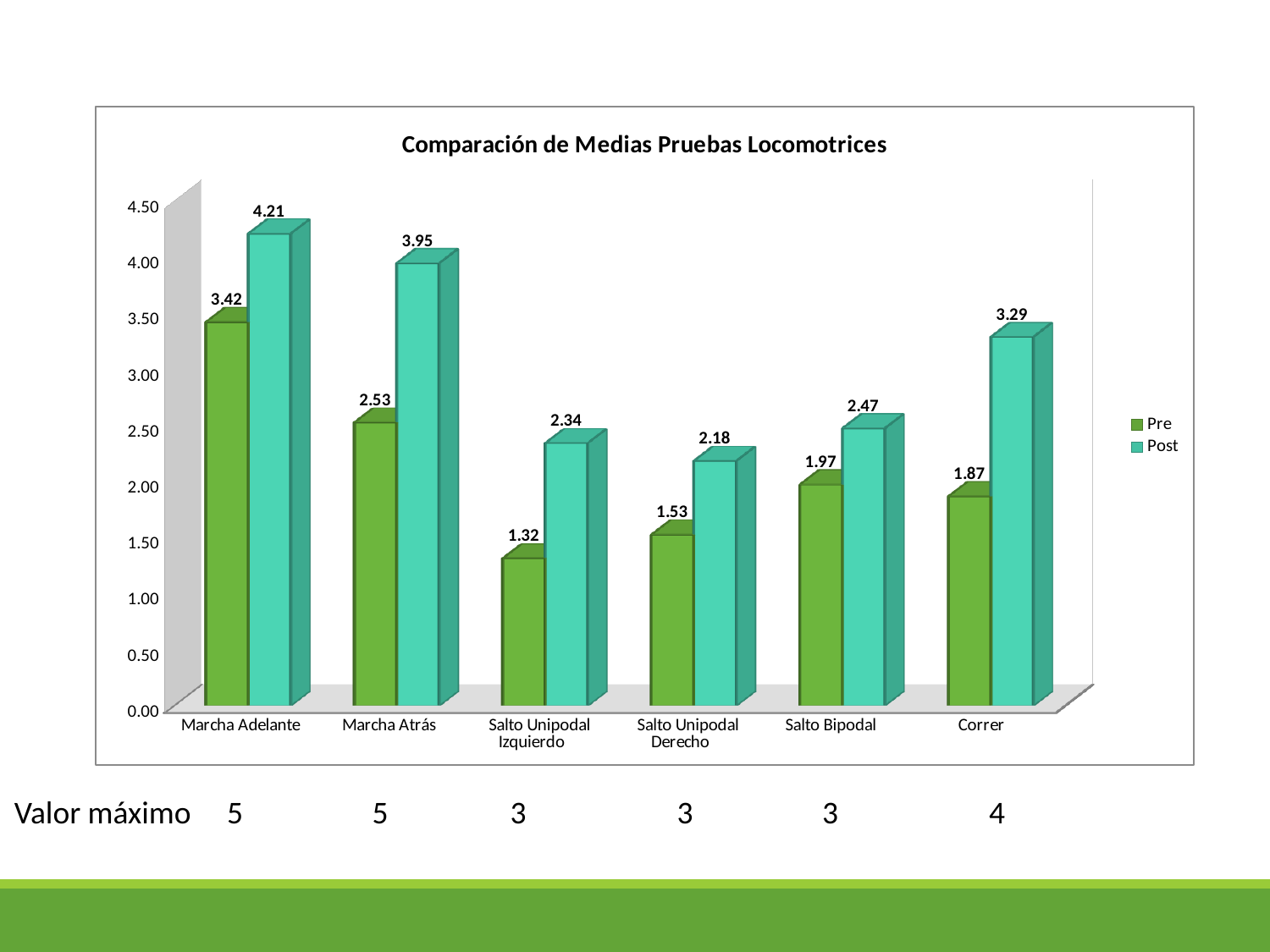
What kind of chart is shown on the slide? Bar chart Is the Post value for Salto Unipodal Derecho greater or less than 2.00? greater What is the Post value for Correr? 3.29 How many series does the legend list? 2 What is the Pre value for Marcha Adelante? 3.42 Which category has the lowest Pre value? Salto Unipodal Izquierdo Which is larger, the Pre value for Salto Bipodal or the Pre value for Correr? Salto Bipodal What is the title of the chart? Comparación de Medias Pruebas Locomotrices Which category has the highest Post value? Marcha Adelante What is the difference between the Post and Pre values for Marcha Atrás? 1.42 What is the Pre value for Salto Unipodal Izquierdo? 1.32 How many categories are shown on the x axis? 6